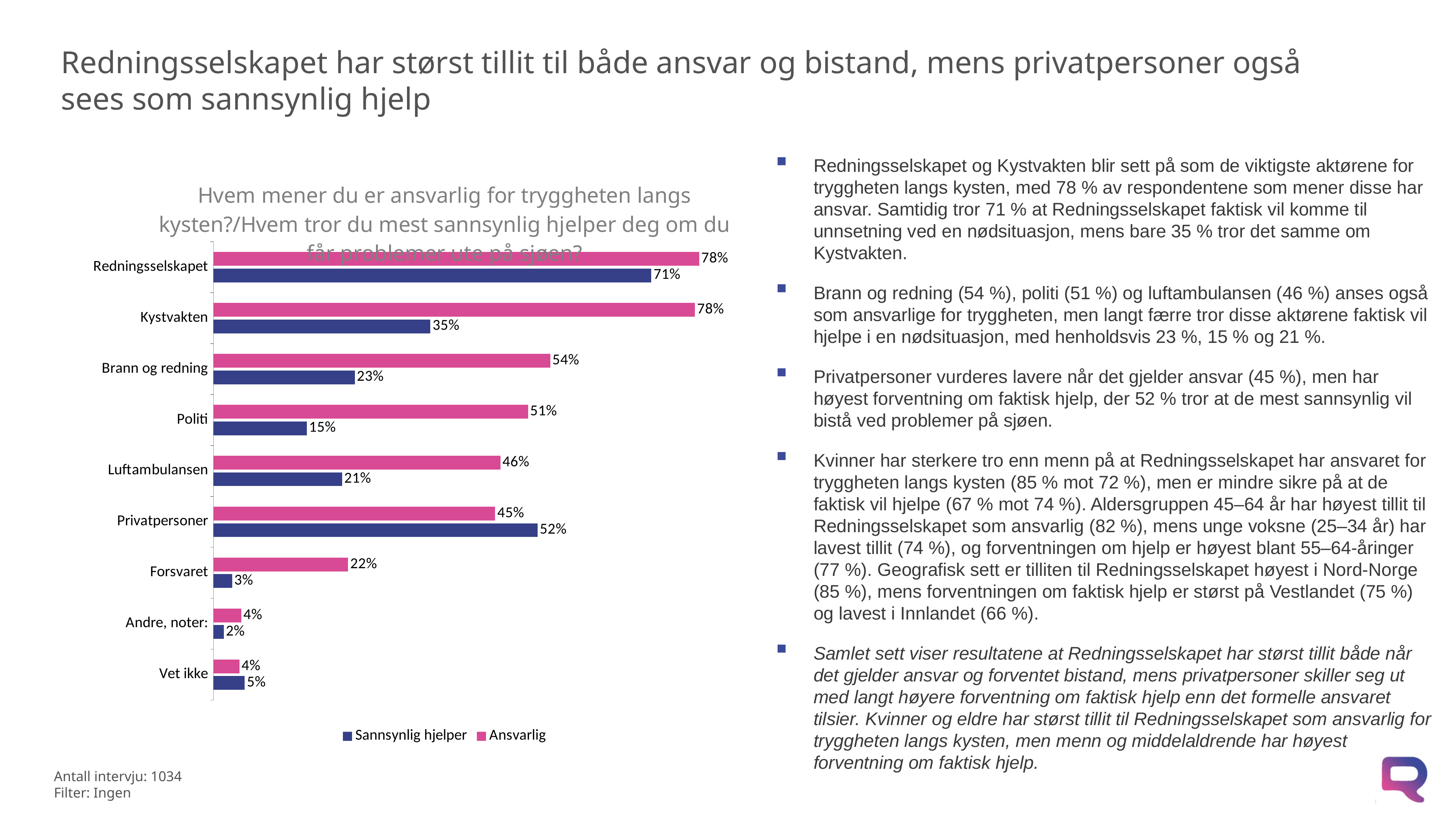
How many categories are shown on the chart? 9 What kind of chart is shown on the slide? Bar chart What is the difference between the 'Ansvarlig' and 'Sannsynlig hjelper' values for Kystvakten? 43 percentage points What is the 'Sannsynlig hjelper' value for Privatpersoner? 52% How many series does the legend list? 2 Which series is shown in pink? Ansvarlig What is the 'Ansvarlig' value for Brann og redning? 54% Which category has the highest 'Sannsynlig hjelper' value? Redningsselskapet Which is larger: the 'Ansvarlig' value for Politi or the 'Ansvarlig' value for Luftambulansen? Politi Which category has the lowest 'Sannsynlig hjelper' value? Andre, noter: What is the 'Sannsynlig hjelper' value for Kystvakten? 35% For Privatpersoner, which is larger: 'Sannsynlig hjelper' or 'Ansvarlig'? Sannsynlig hjelper